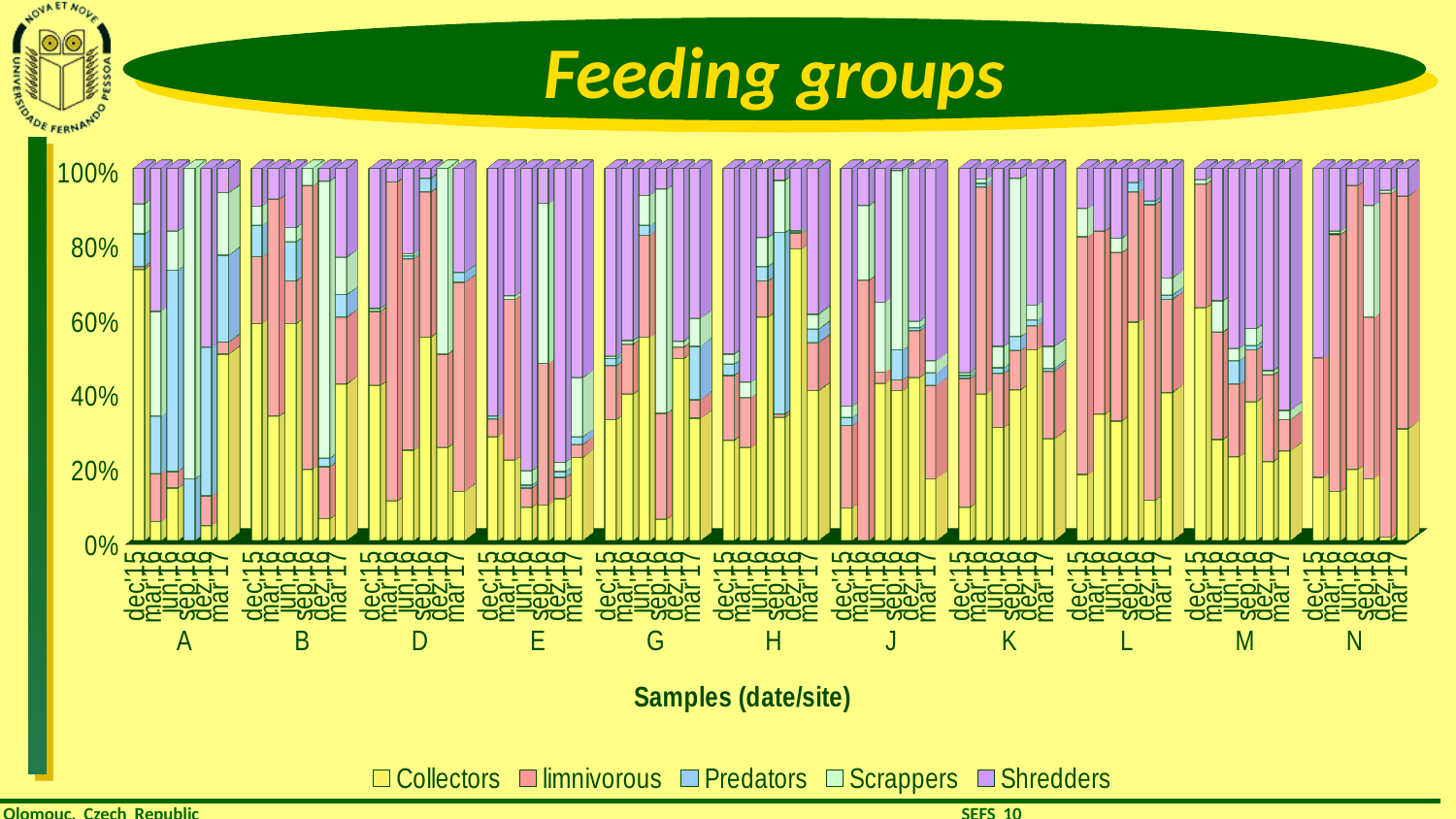
Which series is listed first in the legend? Collectors What is the label of the first site group on the x axis? A What is the x-axis title of the chart? Samples (date/site) Is the Collectors value for the dec'15 bar at site L greater or less than 40%? less What is the maximum value shown on the y axis? 100% Is the Collectors value for the dec'15 bar at site A greater or less than 60%? greater Is the Collectors value for the dec'15 bar at site N greater or less than 40%? less How many series does the legend list? 5 How many sites are shown along the x axis of the chart? 11 What kind of chart is shown on the slide? stacked bar chart What is the title of the chart? Feeding groups Which series is listed last in the legend? Shredders